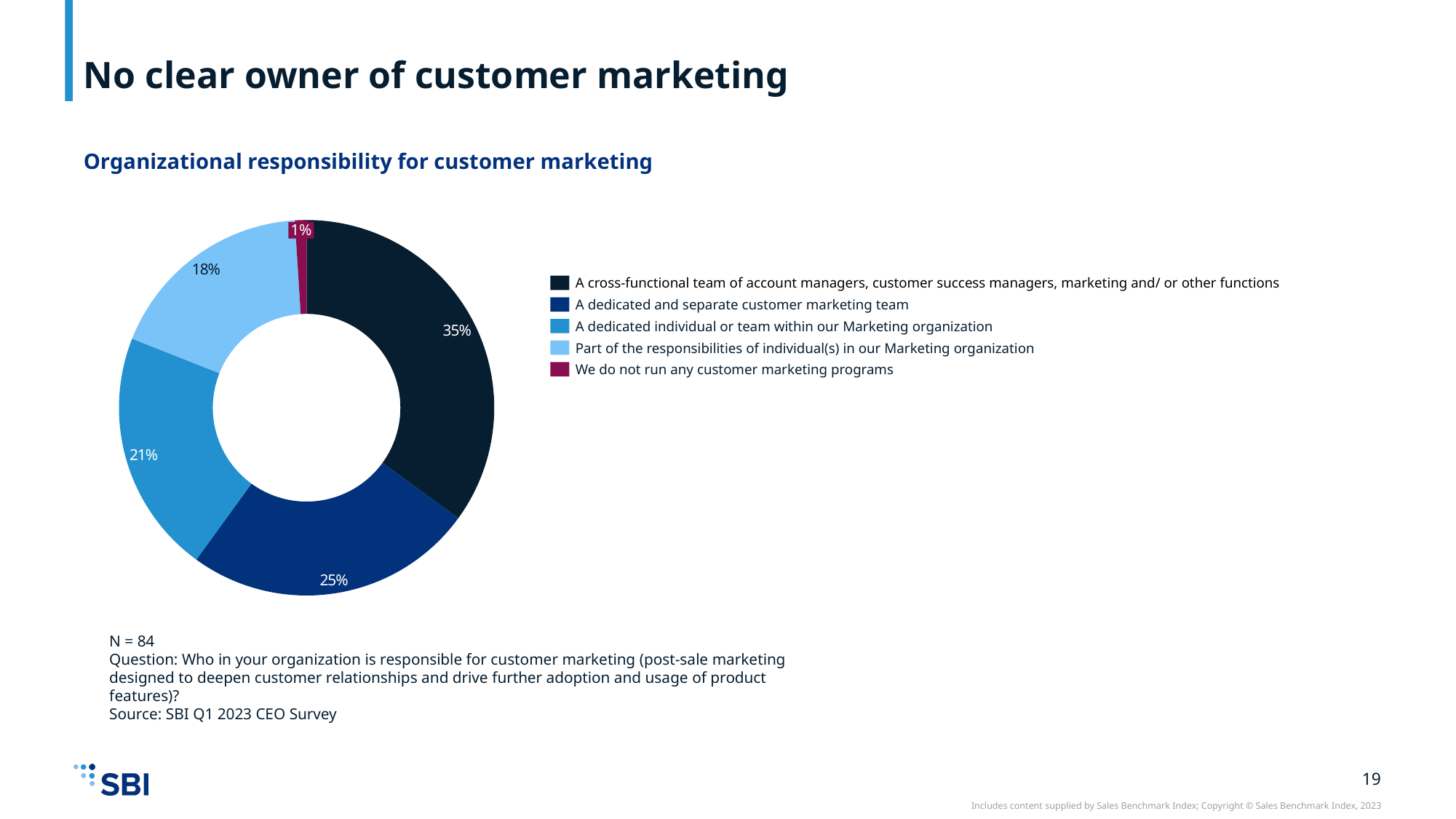
Which is larger: the share for a dedicated individual or team within the Marketing organization, or the share for part of the responsibilities of individual(s) in the Marketing organization? A dedicated individual or team within our Marketing organization How many categories are shown in the chart? 5 What share of respondents do not run any customer marketing programs? 1% What share of respondents said a cross-functional team of account managers, customer success managers, marketing and/or other functions is responsible for customer marketing? 35% Which category has the smallest share of the chart? We do not run any customer marketing programs What is the difference in percentage points between the cross-functional team share and the dedicated and separate customer marketing team share? 10 Which category has the largest share of the chart? A cross-functional team of account managers, customer success managers, marketing and/ or other functions What percentage of respondents said customer marketing is part of the responsibilities of individual(s) in their Marketing organization? 18% What share of respondents said a dedicated individual or team within their Marketing organization is responsible? 21% What is the title of the chart? Organizational responsibility for customer marketing What type of chart is shown on the slide? Pie chart (donut) What percentage of respondents have a dedicated and separate customer marketing team? 25%